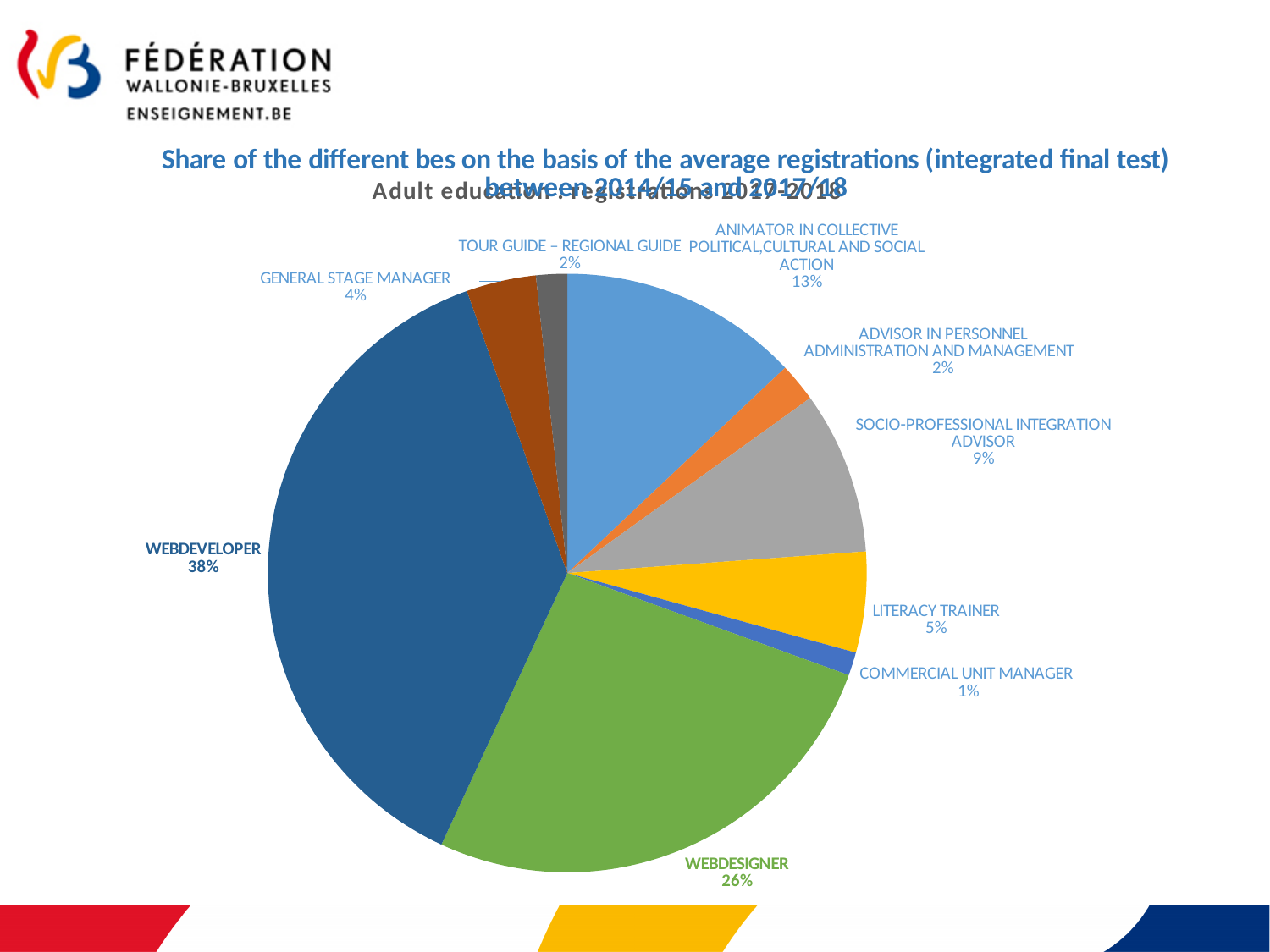
What is the share for LITERACY TRAINER? 5% Which category has the largest share of the pie? WEBDEVELOPER What colour is the WEBDESIGNER slice? Green Which category has the smallest share of the pie? COMMERCIAL UNIT MANAGER What is the share for SOCIO-PROFESSIONAL INTEGRATION ADVISOR? 9% What is the difference in percentage points between the WEBDEVELOPER and WEBDESIGNER shares? 12 How many slices does the pie chart have? 9 What is the share for ANIMATOR IN COLLECTIVE POLITICAL, CULTURAL AND SOCIAL ACTION? 13% Which has the larger share, GENERAL STAGE MANAGER or LITERACY TRAINER? LITERACY TRAINER What share of the pie does WEBDEVELOPER hold? 38% What share of the pie does WEBDESIGNER hold? 26% What kind of chart is shown on the slide? Pie chart